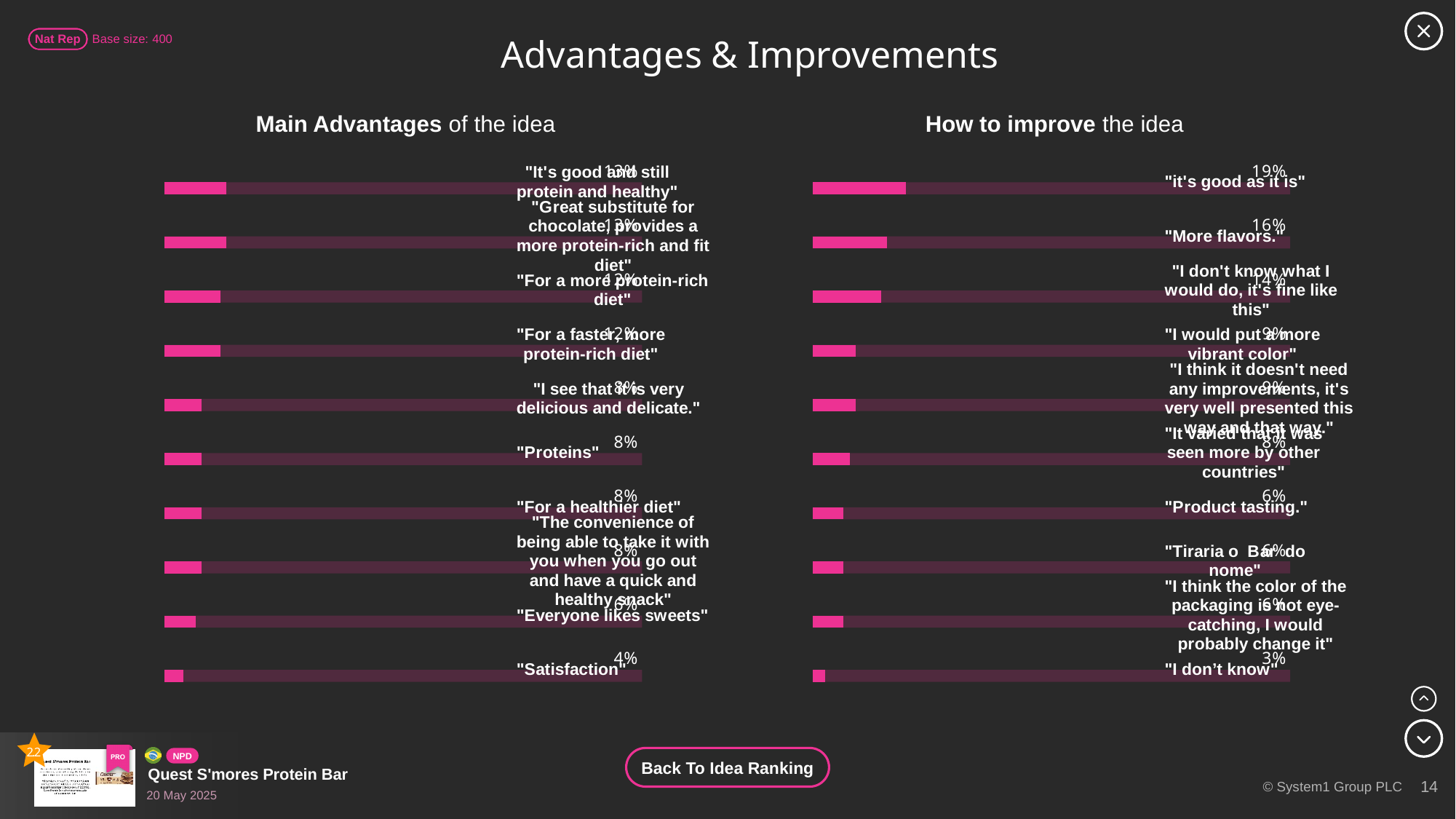
What type of chart is the "Main Advantages of the idea" chart? Bar chart In the "Main Advantages of the idea" chart, which category has the lowest value? "Satisfaction" In the "Main Advantages of the idea" chart, what is the value for "Proteins"? 8% In the "How to improve the idea" chart, what is the difference between "it's good as it is" and "More flavors."? 3% In the "How to improve the idea" chart, what is the value for "it's good as it is"? 19% In the "How to improve the idea" chart, which category has the lowest value? "I don't know" In the "Main Advantages of the idea" chart, what is the value for "Everyone likes sweets"? 6% In the "How to improve the idea" chart, what is the value for "More flavors."? 16% How many categories are shown in the "How to improve the idea" chart? 10 In the "Main Advantages of the idea" chart, which is larger: "Everyone likes sweets" or "Satisfaction"? "Everyone likes sweets" In the "How to improve the idea" chart, which category has the highest value? "it's good as it is" In the "Main Advantages of the idea" chart, what is the value for "Satisfaction"? 4%